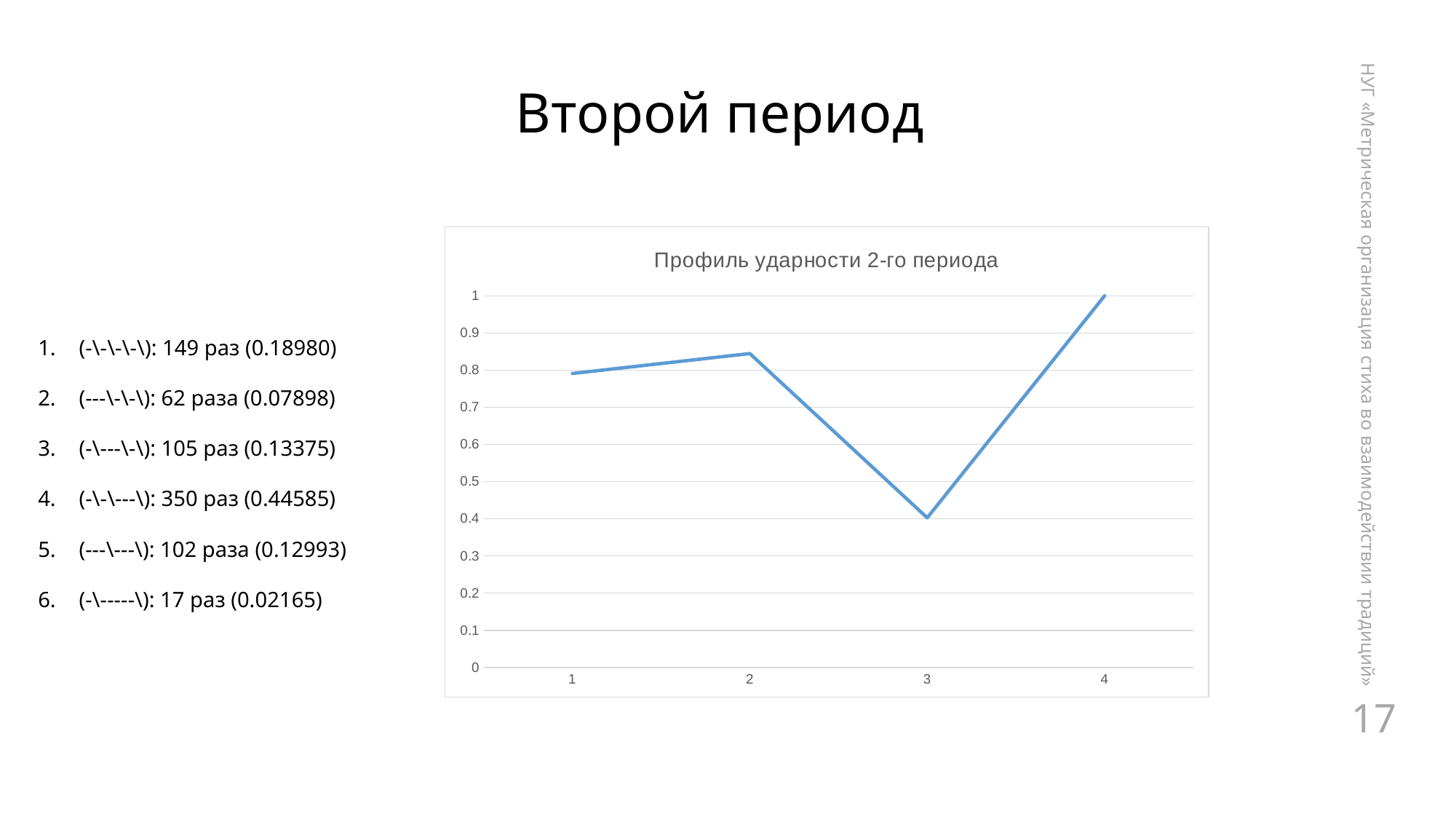
Which x-axis position has the lowest value? 3 Does the line rise or fall between x-axis positions 3 and 4? rise Does the line rise or fall between x-axis positions 2 and 3? fall How many points are plotted on the line? 4 Which is larger, the value at position 2 or the value at position 3? position 2 What is the value at x-axis position 4? 1 Is the value at x-axis position 3 greater or less than 0.5? less What is the title of the chart? Профиль ударности 2-го периода Is the value at x-axis position 1 greater or less than 0.7? greater Which x-axis position has the highest value? 4 What kind of chart is shown on the slide? line chart Is the value at x-axis position 2 greater or less than 0.9? less